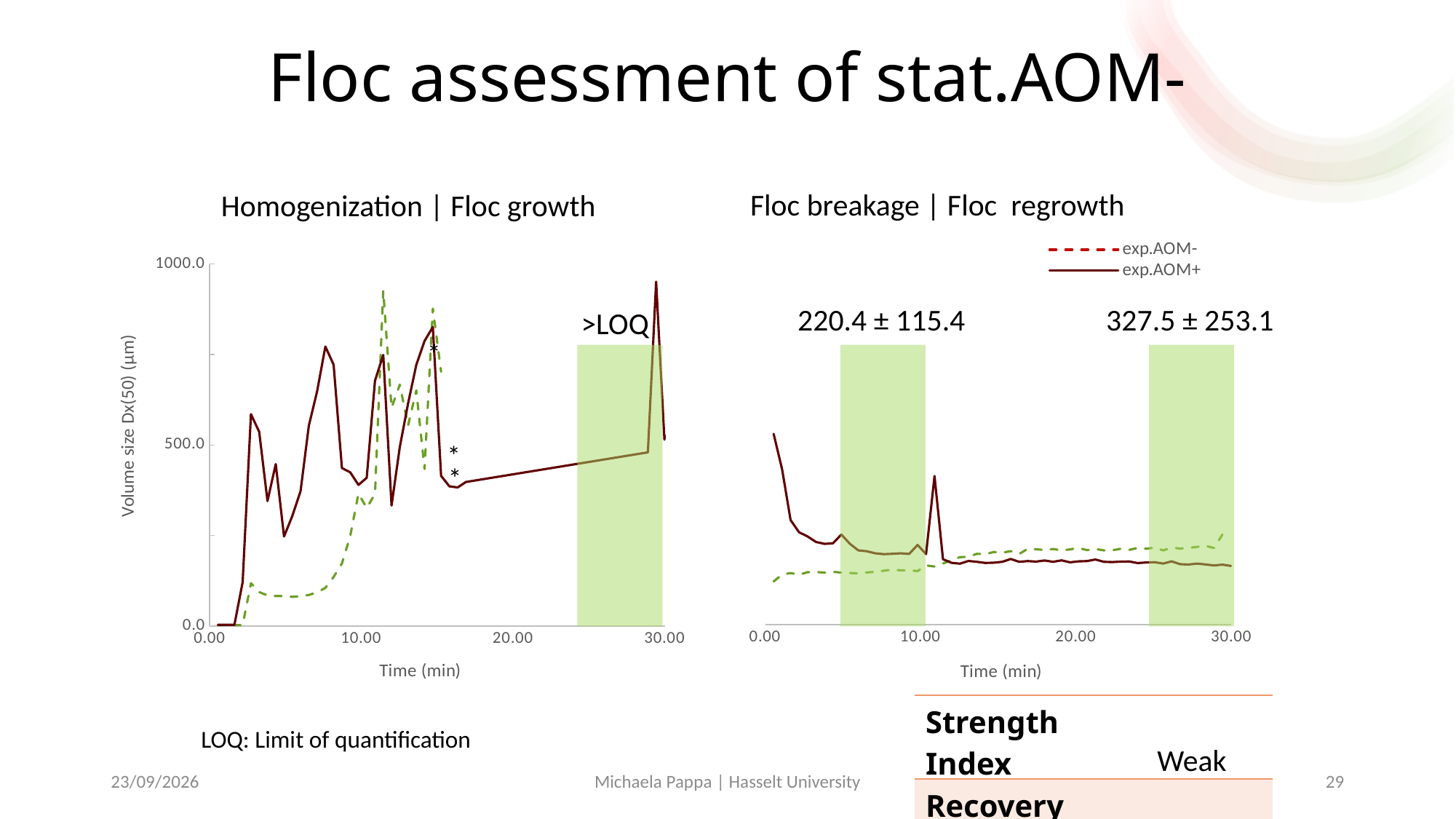
In the left chart 'Homogenization | Floc growth', is the value of the dashed line at 5.00 min greater or less than 500.0? less In the left chart 'Homogenization | Floc growth', does the dashed line rise or fall between 5.00 and 10.00 min? rise In the right chart 'Floc breakage | Floc regrowth', what value is annotated above the first shaded region? 220.4 ± 115.4 What kind of chart is the left chart titled 'Homogenization | Floc growth'? line chart In the right chart 'Floc breakage | Floc regrowth', what value is annotated above the second shaded region? 327.5 ± 253.1 In the right chart 'Floc breakage | Floc regrowth', how many series does the legend list? 2 In the right chart 'Floc breakage | Floc regrowth', which series is drawn with a dashed line according to the legend? exp.AOM- What kind of chart is the right chart titled 'Floc breakage | Floc regrowth'? line chart What is the y-axis title of the left chart 'Homogenization | Floc growth'? Volume size Dx(50) (µm) In the right chart 'Floc breakage | Floc regrowth', does the exp.AOM+ line rise or fall between 0.00 and 5.00 min? fall In the left chart 'Homogenization | Floc growth', is the value of the solid line at 20.00 min greater or less than 500.0? less